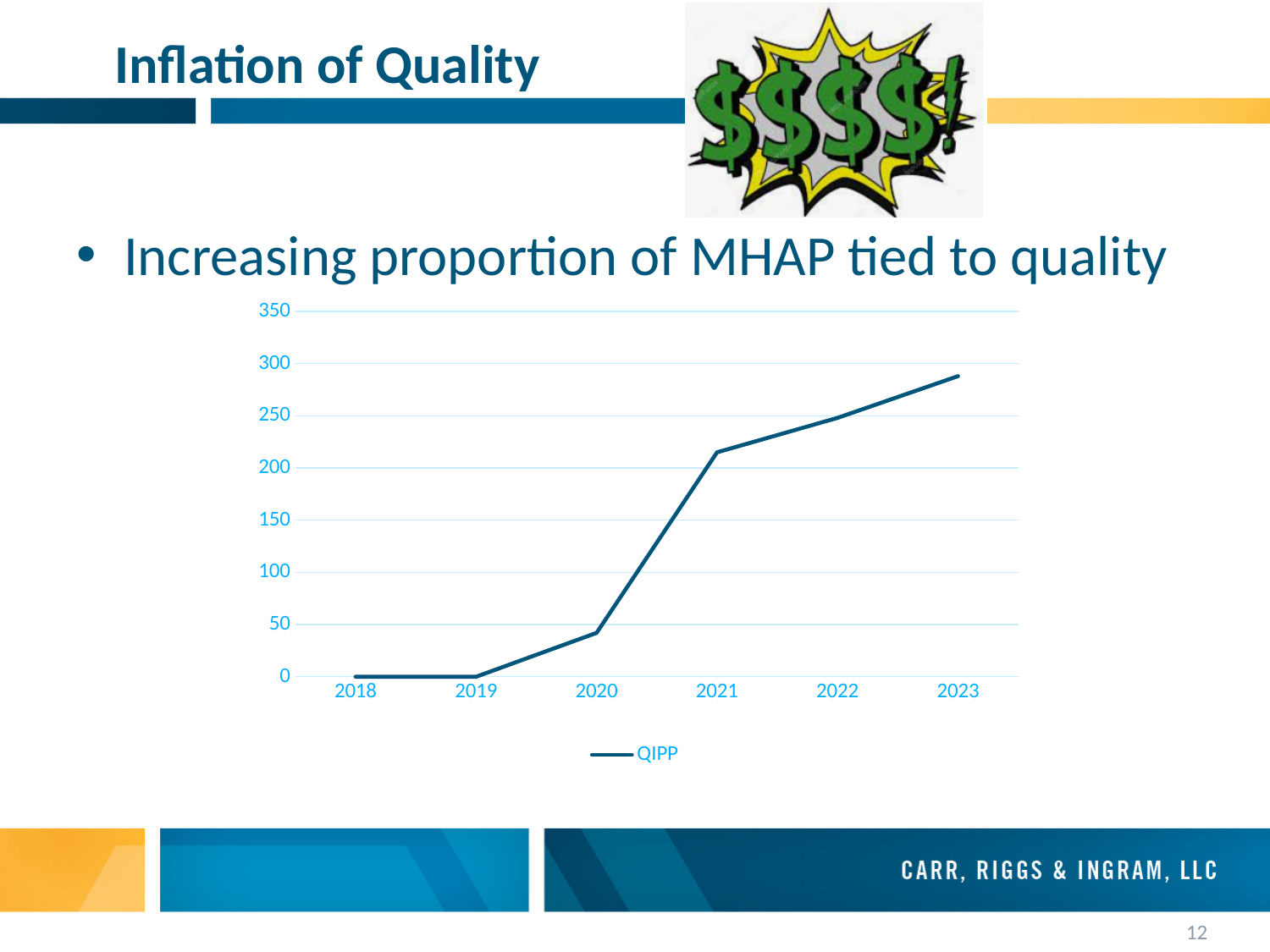
How many years are plotted along the x axis? 6 What is the QIPP value for 2018? 0 Which year has the highest QIPP value? 2023 Is the QIPP value for 2022 greater or less than 200? greater Is the QIPP value for 2021 greater or less than 200? greater How many series does the legend list? 1 Do the QIPP values rise or fall from 2018 to 2023? rise Is the QIPP value for 2020 greater or less than 50? less Which year has the larger QIPP value, 2020 or 2021? 2021 What kind of chart is shown on the slide? line chart What is the name of the series shown in the legend? QIPP